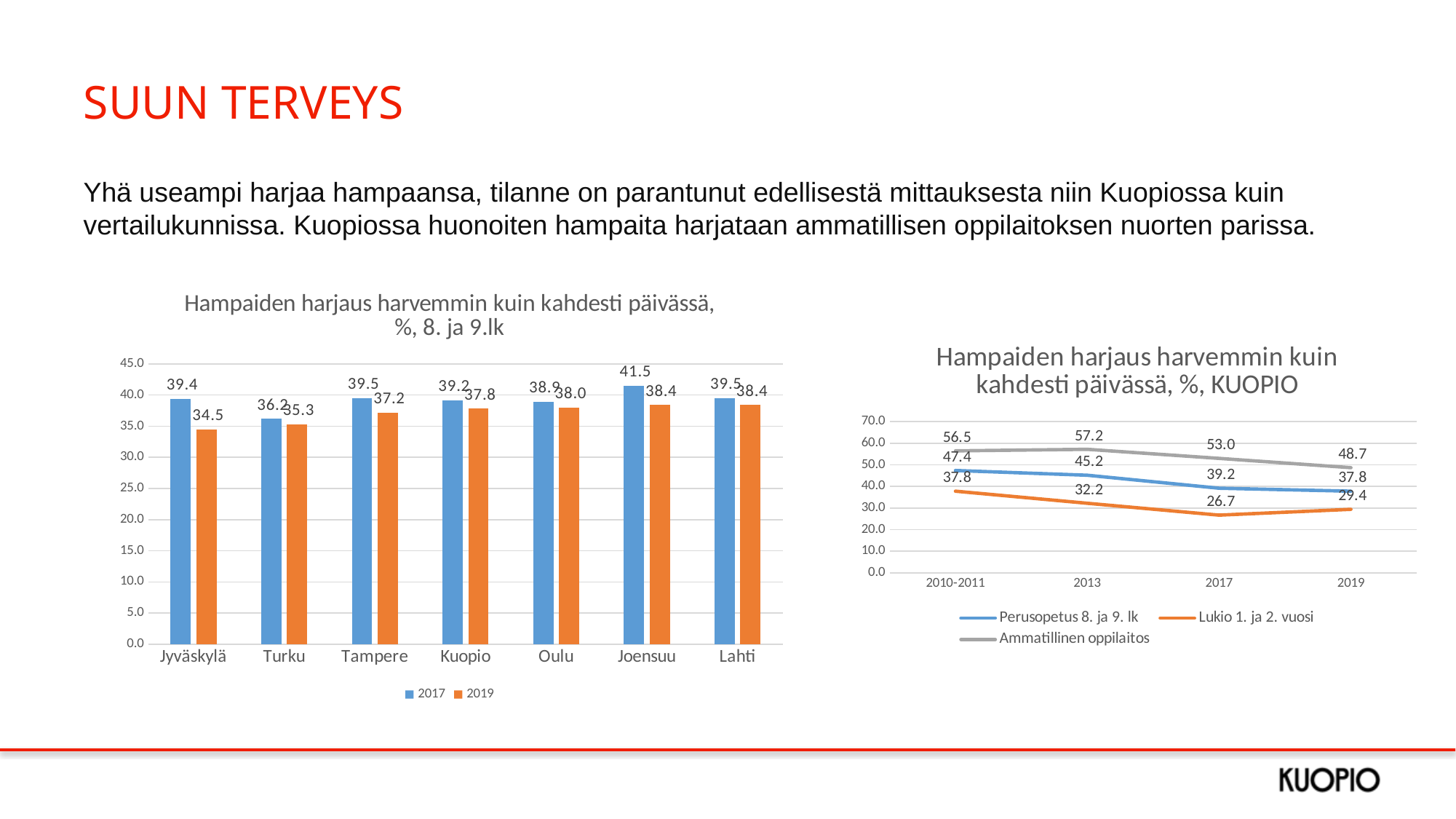
In the right chart (KUOPIO), which is larger in 2013: Ammatillinen oppilaitos or Perusopetus 8. ja 9. lk? Ammatillinen oppilaitos In the right chart (KUOPIO), what is the value for Ammatillinen oppilaitos in 2019? 48.7 In the left chart (8. ja 9.lk), what is the difference between the 2017 and 2019 values for Jyväskylä? 4.9 What kind of chart is the left chart (8. ja 9.lk)? Bar chart In the left chart (8. ja 9.lk), how many cities are shown on the x axis? 7 In the right chart (KUOPIO), does the Perusopetus 8. ja 9. lk series rise or fall from 2010-2011 to 2019? Fall In the left chart (8. ja 9.lk), what is the 2019 value for Kuopio? 37.8 In the right chart (KUOPIO), what is the value for Lukio 1. ja 2. vuosi in 2017? 26.7 In the left chart (8. ja 9.lk), which city has the lowest 2019 value? Jyväskylä In the left chart (8. ja 9.lk), which city has the highest 2017 value? Joensuu In the left chart (8. ja 9.lk), what is the 2017 value for Jyväskylä? 39.4 In the right chart (KUOPIO), how many series does the legend list? 3